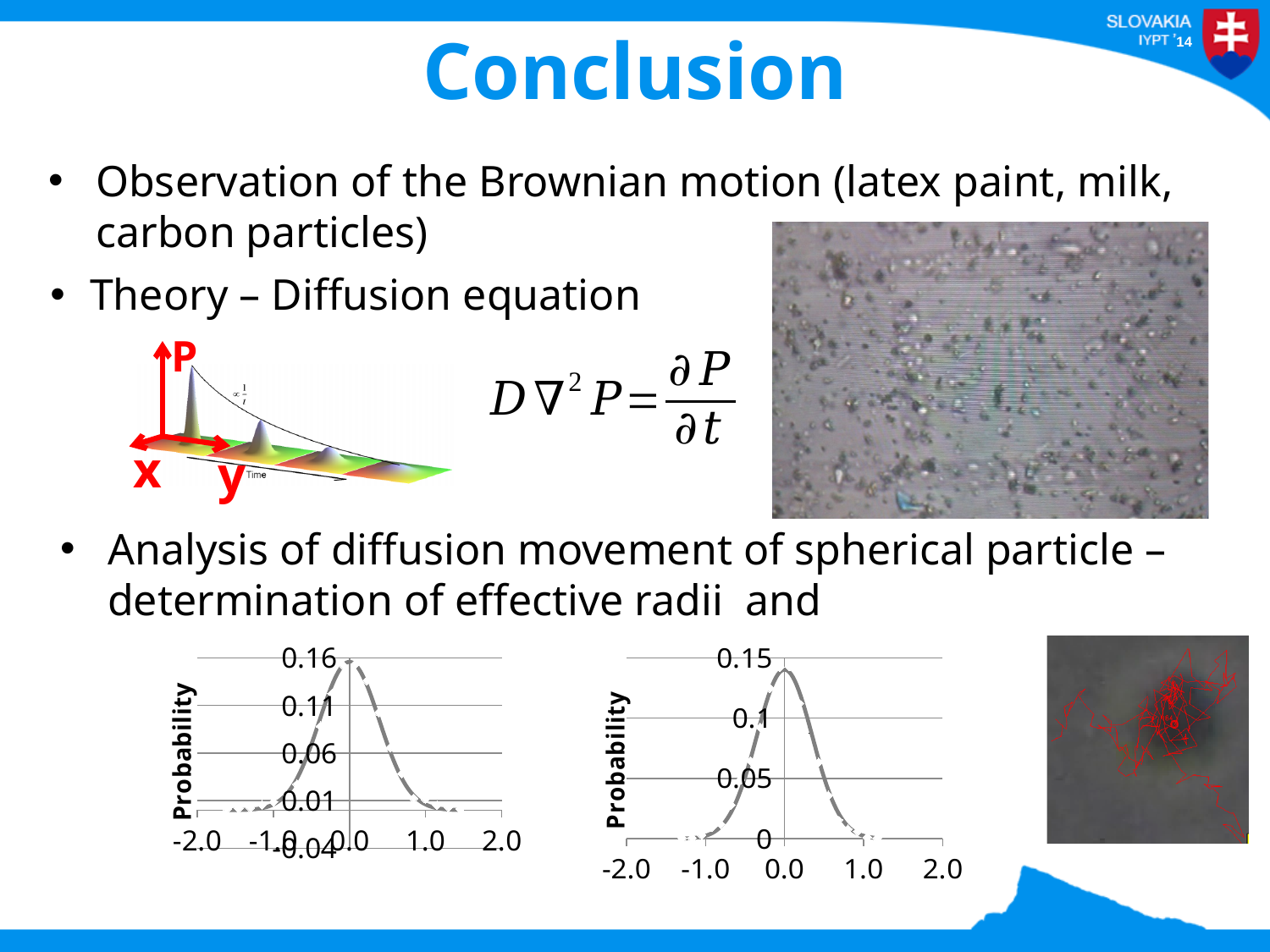
What is the y-axis label of the left chart? Probability In the right chart, is the value of the curve at x = 1.0 greater or less than 0.05? less In the right chart, is the peak value of the curve greater or less than 0.1? greater In the left chart, is the value of the curve at x = 1.0 greater or less than 0.06? less What kind of chart is the left chart at the bottom of the slide? line chart In the left chart, do the values rise or fall as x goes from 0.0 to 2.0? fall What kind of chart is the right chart at the bottom of the slide? line chart In the left chart, at which x-axis value does the curve reach its highest probability? 0.0 How many labelled tick values are shown on the x axis of the right chart? 5 In the right chart, at which x-axis value does the curve reach its highest probability? 0.0 In the right chart, do the values rise or fall as x goes from -2.0 to 0.0? rise